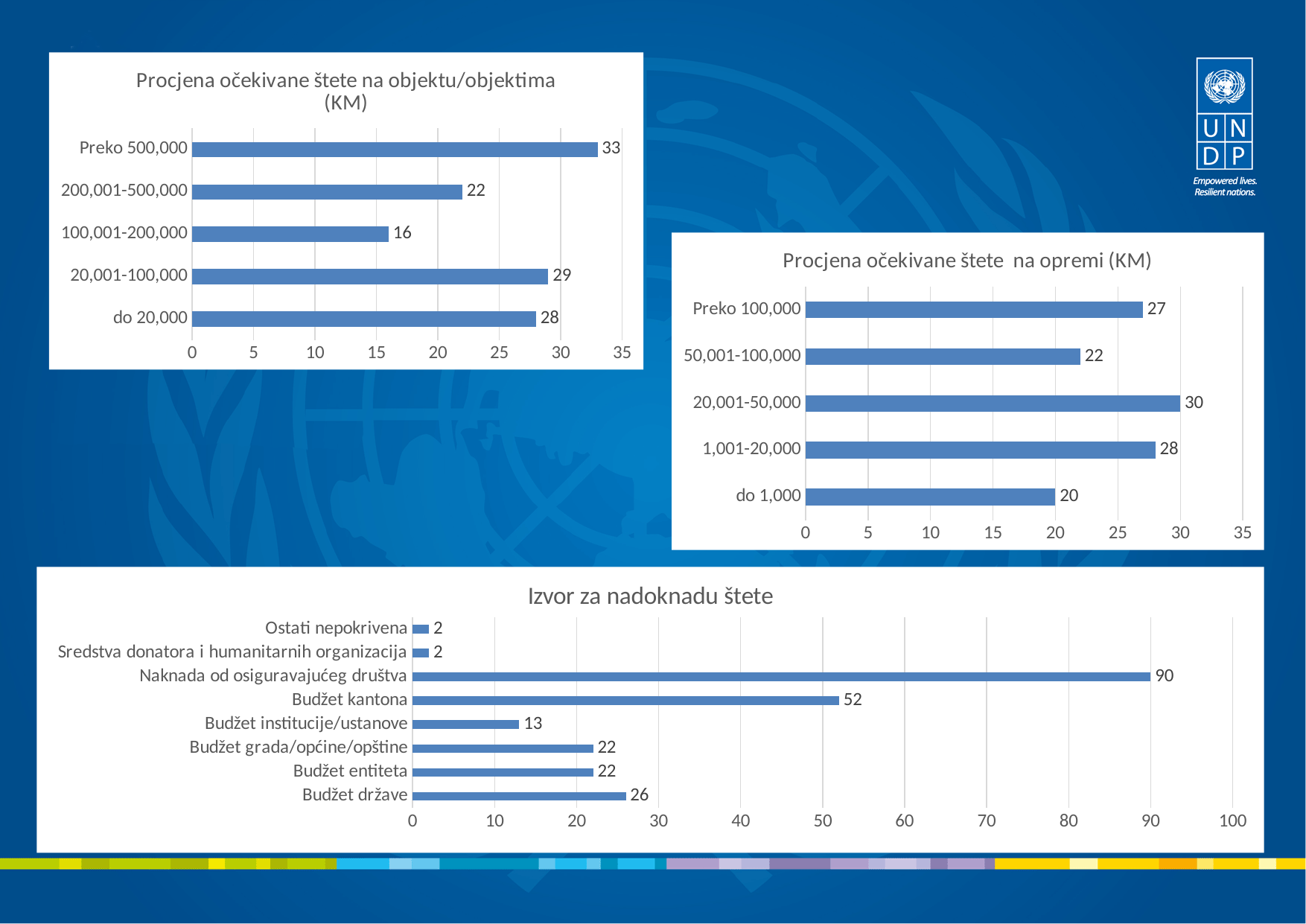
In the chart 'Procjena očekivane štete na opremi (KM)', which is larger: the value for 'Preko 100,000' or the value for '50,001-100,000'? Preko 100,000 How many categories are shown in the chart 'Izvor za nadoknadu štete'? 8 In the chart 'Procjena očekivane štete na objektu/objektima (KM)', which category has the lowest value? 100,001-200,000 In the chart 'Procjena očekivane štete na opremi (KM)', what is the value for 'do 1,000'? 20 In the chart 'Izvor za nadoknadu štete', what is the difference between the values for 'Naknada od osiguravajućeg društva' and 'Budžet kantona'? 38 In the chart 'Procjena očekivane štete na objektu/objektima (KM)', what is the value for 'Preko 500,000'? 33 In the chart 'Izvor za nadoknadu štete', what is the value for 'Budžet kantona'? 52 In the chart 'Izvor za nadoknadu štete', which category has the highest value? Naknada od osiguravajućeg društva In the chart 'Procjena očekivane štete na objektu/objektima (KM)', what is the difference between the values for '20,001-100,000' and '200,001-500,000'? 7 In the chart 'Procjena očekivane štete na opremi (KM)', which category has the highest value? 20,001-50,000 How many categories are shown in the chart 'Procjena očekivane štete na objektu/objektima (KM)'? 5 What type of chart is 'Izvor za nadoknadu štete'? Bar chart